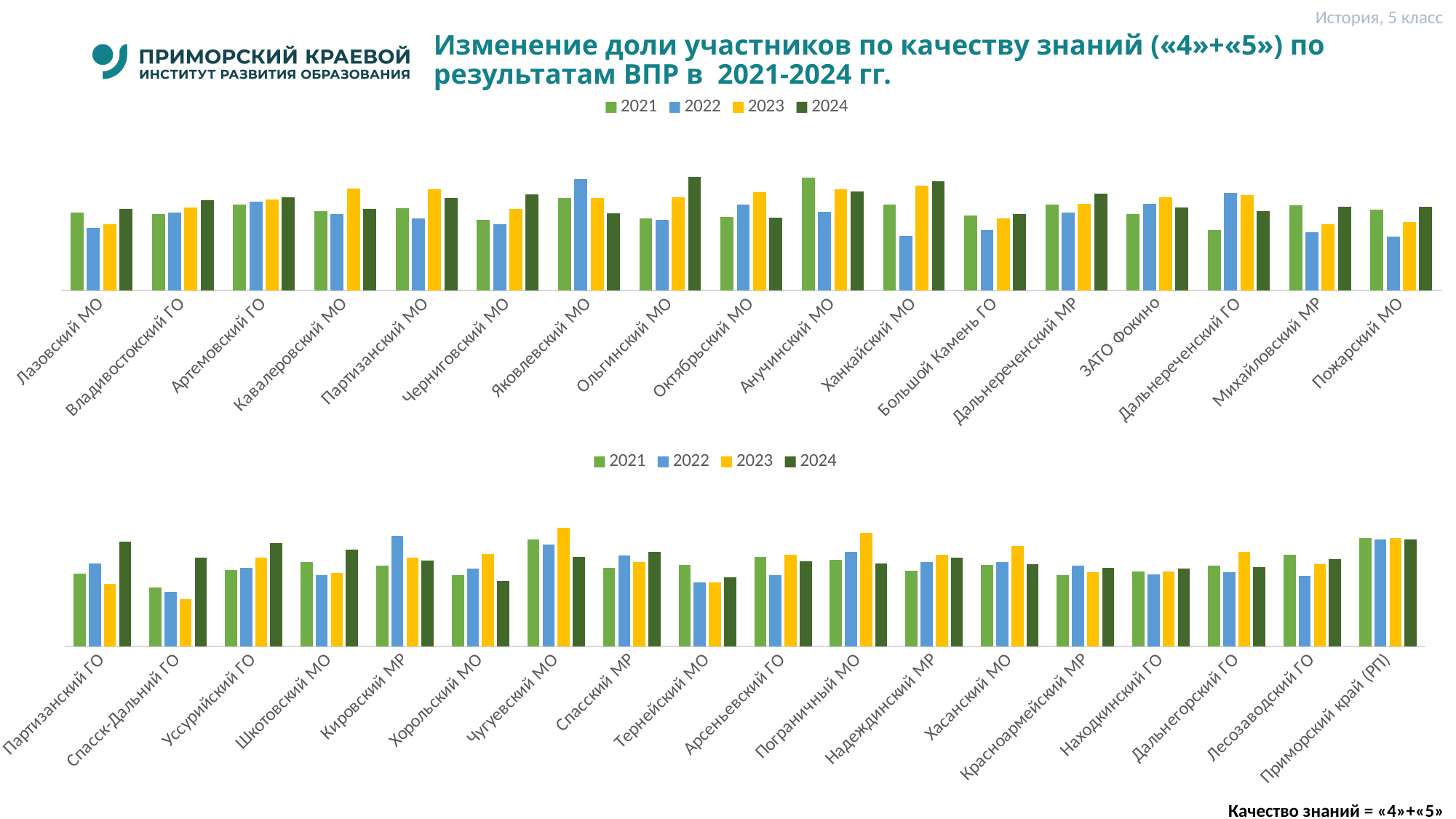
In the top chart, which year has the highest bar for Яковлевский МО? 2022 In the bottom chart, which year has the highest bar for Кировский МР? 2022 In the top chart, for Анучинский МО, which is larger: the 2021 value or the 2022 value? 2021 How many categories are shown on the x axis of the bottom chart? 18 In the top chart, which year has the highest bar for Ольгинский МО? 2024 What kind of chart is the top chart on the slide? bar chart Which series is shown in yellow in the legend of the charts? 2023 How many categories are shown on the x axis of the top chart? 17 How many series does the legend of the top chart list? 4 In the top chart, which year has the lowest bar for Ханкайский МО? 2022 In the bottom chart, which year has the lowest bar for Спасск-Дальний ГО? 2023 In the bottom chart, for Партизанский ГО, which is larger: the 2024 value or the 2023 value? 2024